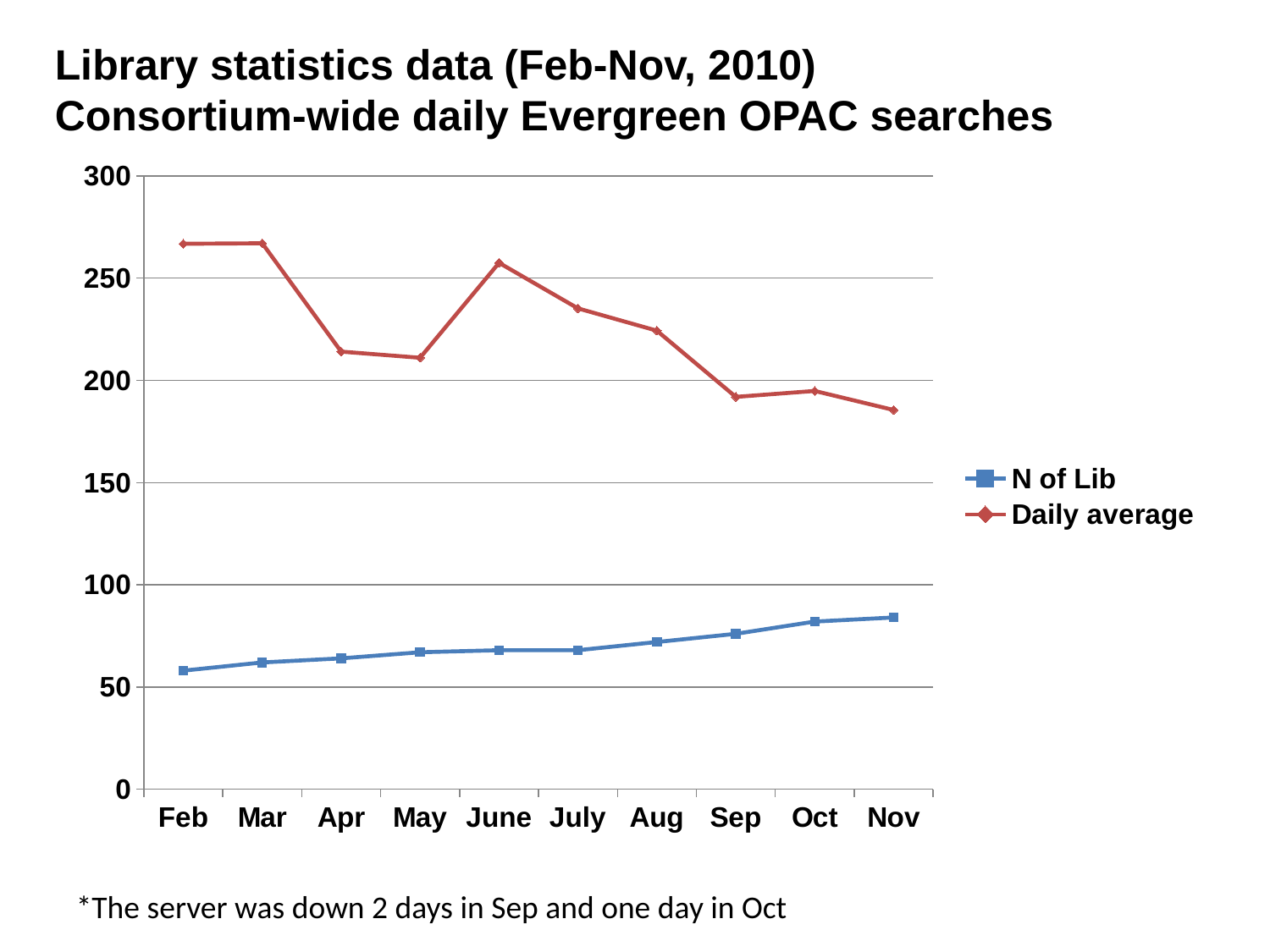
Which series is drawn in red? Daily average Which month has the lowest N of Lib value? Feb Does the N of Lib series rise or fall from Feb to Nov? Rise How many months are plotted along the x axis? 10 Is the Daily average value for Feb greater or less than 250? greater Which is larger, the Daily average for June or for July? June Is the Daily average value for Nov greater or less than 200? less Is the Daily average value for Apr greater or less than 250? less What kind of chart is shown on the slide? Line chart How many series does the legend list? 2 Which month has the highest N of Lib value? Nov